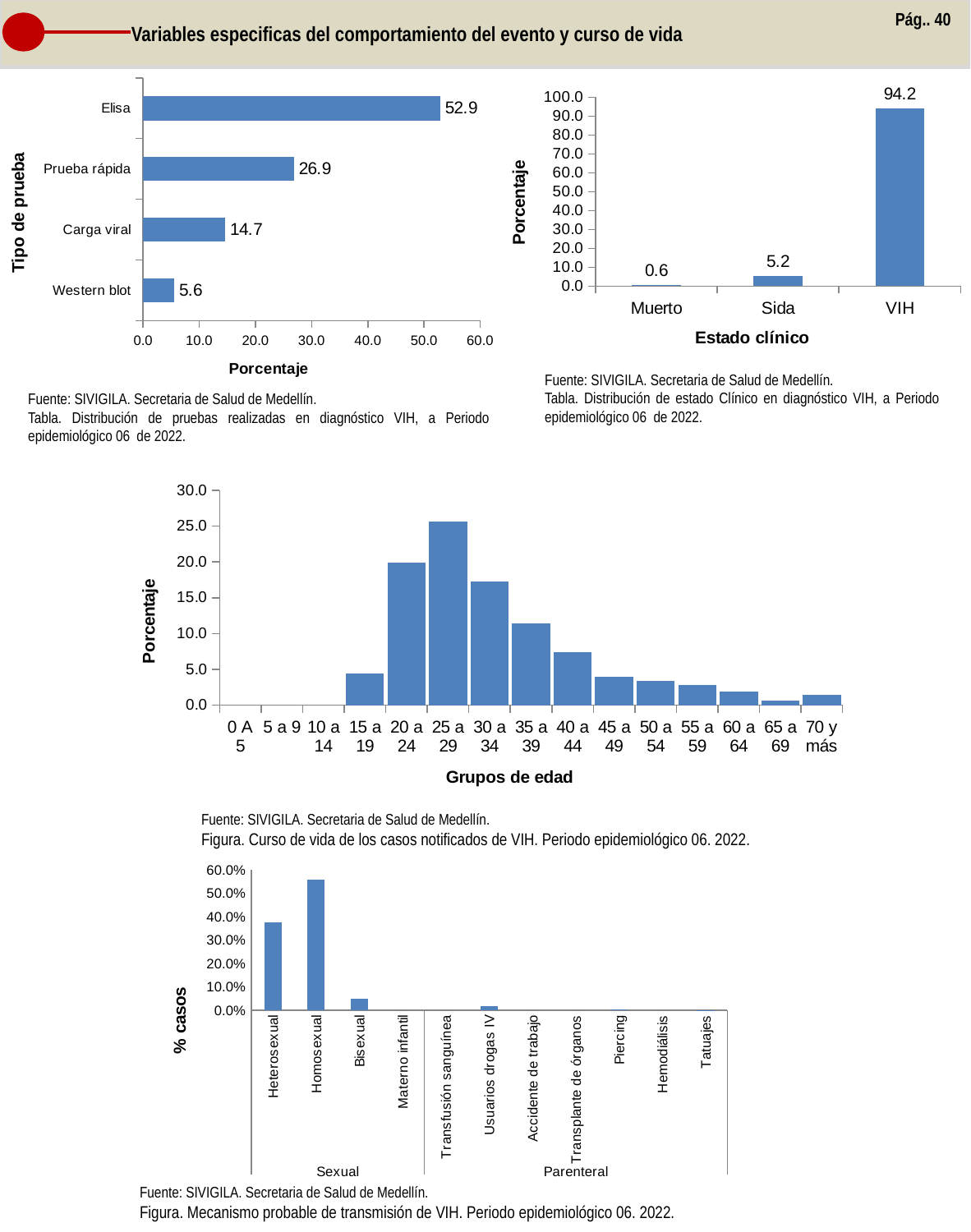
In the top-left chart (Tipo de prueba), which test type has the lowest percentage? Western blot In the middle chart (Grupos de edad), is the value for 25 a 29 greater or less than 20.0? greater In the bottom chart (% casos, mecanismo de transmisión), which category has the highest value? Homosexual What kind of chart is the top-left chart (Tipo de prueba)? Bar chart In the top-left chart (Tipo de prueba), what is the value for Elisa? 52.9 In the top-right chart (Estado clínico), which category has the lowest value? Muerto How many age groups are shown on the x axis of the middle chart (Grupos de edad)? 15 In the bottom chart (% casos, mecanismo de transmisión), is the value for Heterosexual greater or less than 30.0%? greater In the top-right chart (Estado clínico), what is the value for VIH? 94.2 In the top-right chart (Estado clínico), what is the difference between the values for VIH and Sida? 89.0 In the top-left chart (Tipo de prueba), what is the difference between the values for Elisa and Prueba rápida? 26.0 In the middle chart (Grupos de edad), which age group has the highest percentage? 25 a 29